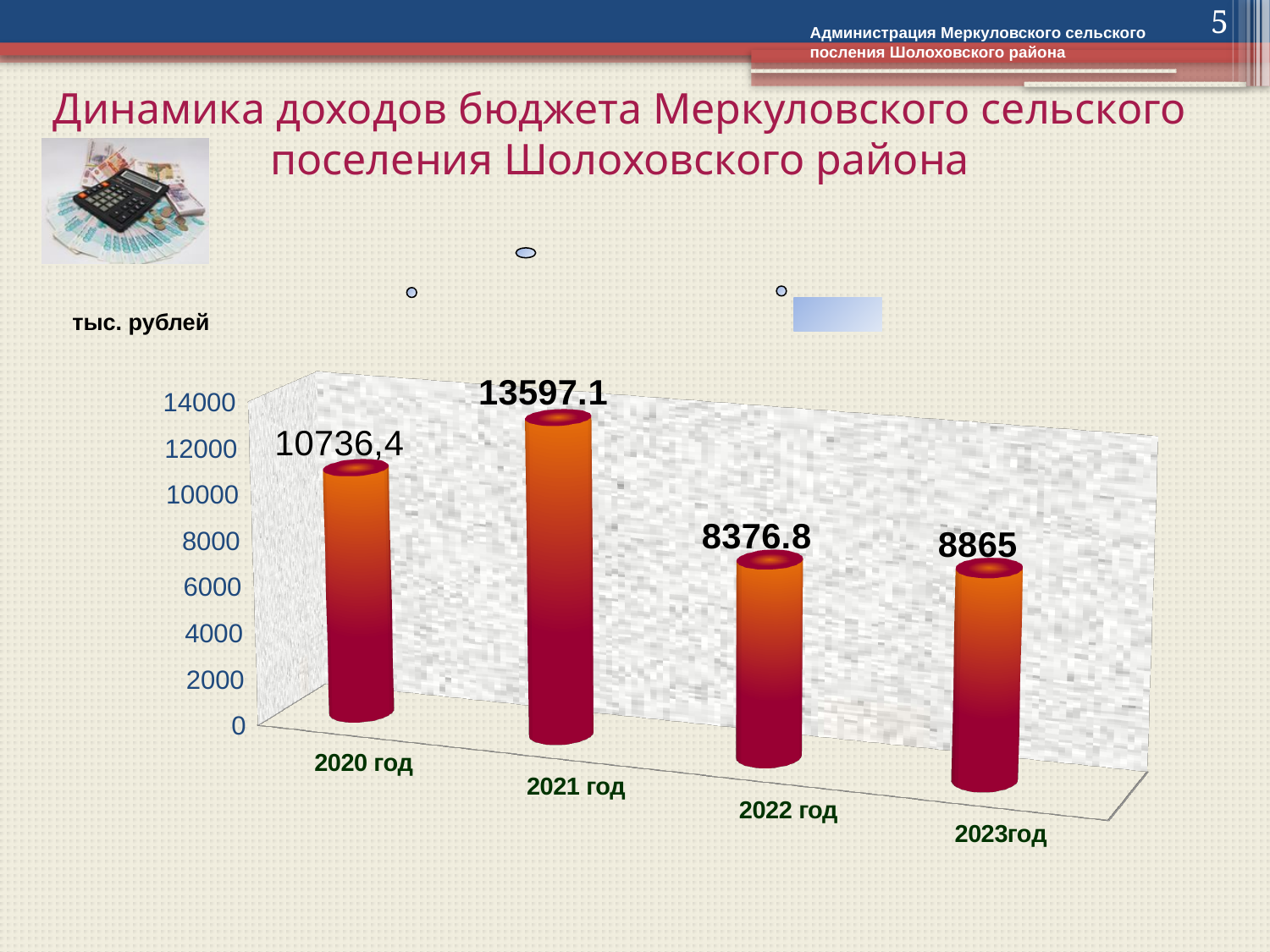
What is the value for 2023год? 8865 What is the difference between the values for 2023год and 2022 год? 488.2 What is the difference between the values for 2021 год and 2020 год? 2860.7 How many years are shown on the chart? 4 Which is larger, the value for 2020 год or the value for 2023год? 2020 год What unit of measurement is indicated for the chart values? тыс. рублей What is the value for 2020 год? 10736,4 What kind of chart is shown on the slide? bar chart Which year has the lowest value? 2022 год Which year has the highest value? 2021 год What is the value for 2022 год? 8376.8 What is the value for 2021 год? 13597.1